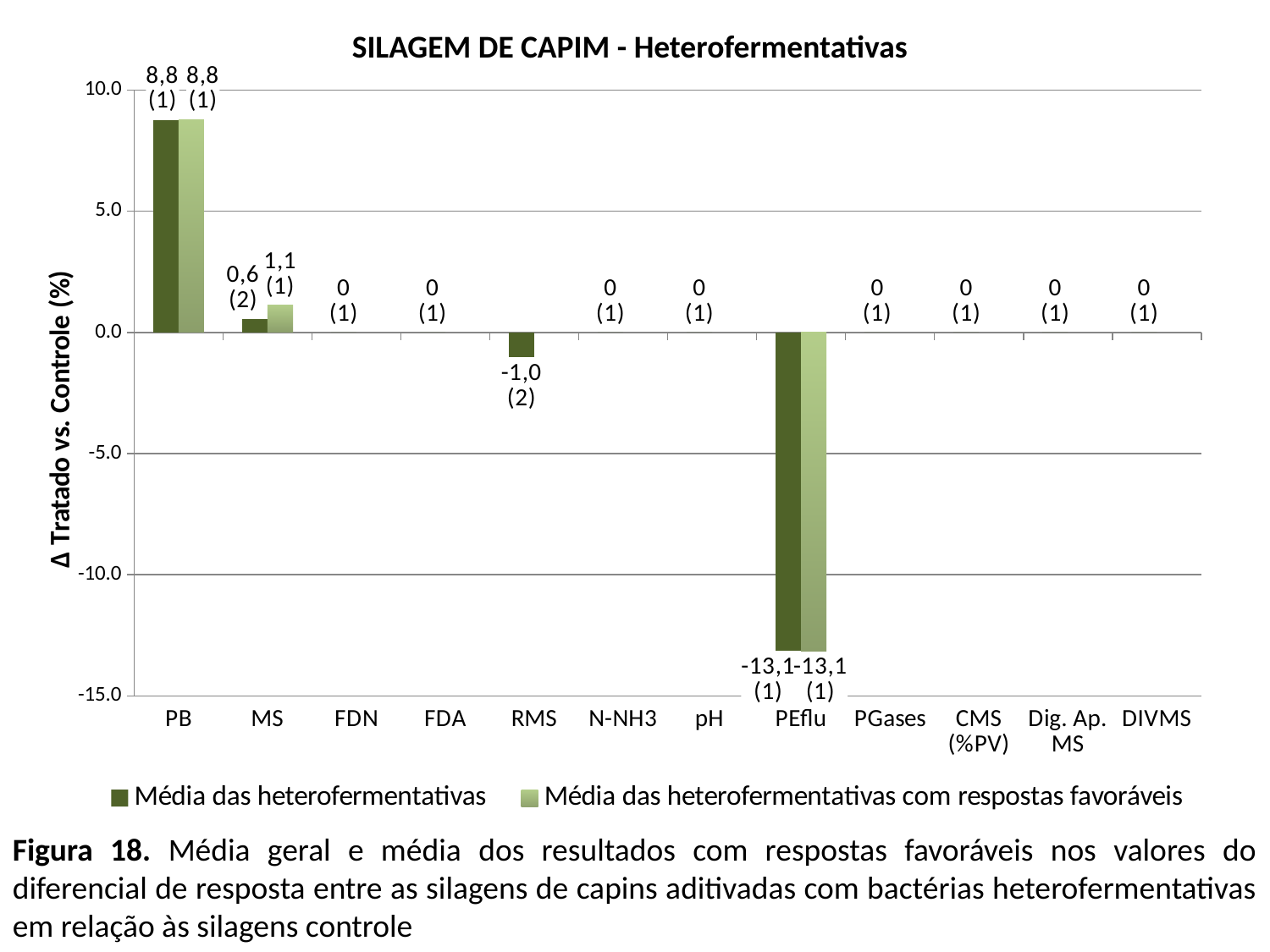
What is the value for RMS in the 'Média das heterofermentativas' series? -1,0 What is the title of the chart? SILAGEM DE CAPIM - Heterofermentativas What is the value for PEflu in the 'Média das heterofermentativas' series? -13,1 What kind of chart is shown on the slide? Bar chart How many categories are shown on the x axis? 12 Which category has the highest value in the 'Média das heterofermentativas' series? PB Which category has the lowest value in the 'Média das heterofermentativas' series? PEflu For MS, what is the difference between the 'Média das heterofermentativas com respostas favoráveis' value and the 'Média das heterofermentativas' value? 0,5 What is the value for PB in the 'Média das heterofermentativas' series? 8,8 In the 'Média das heterofermentativas' series, which is larger: the value for PB or the value for MS? PB How many series does the legend list? 2 What is the value for MS in the 'Média das heterofermentativas com respostas favoráveis' series? 1,1